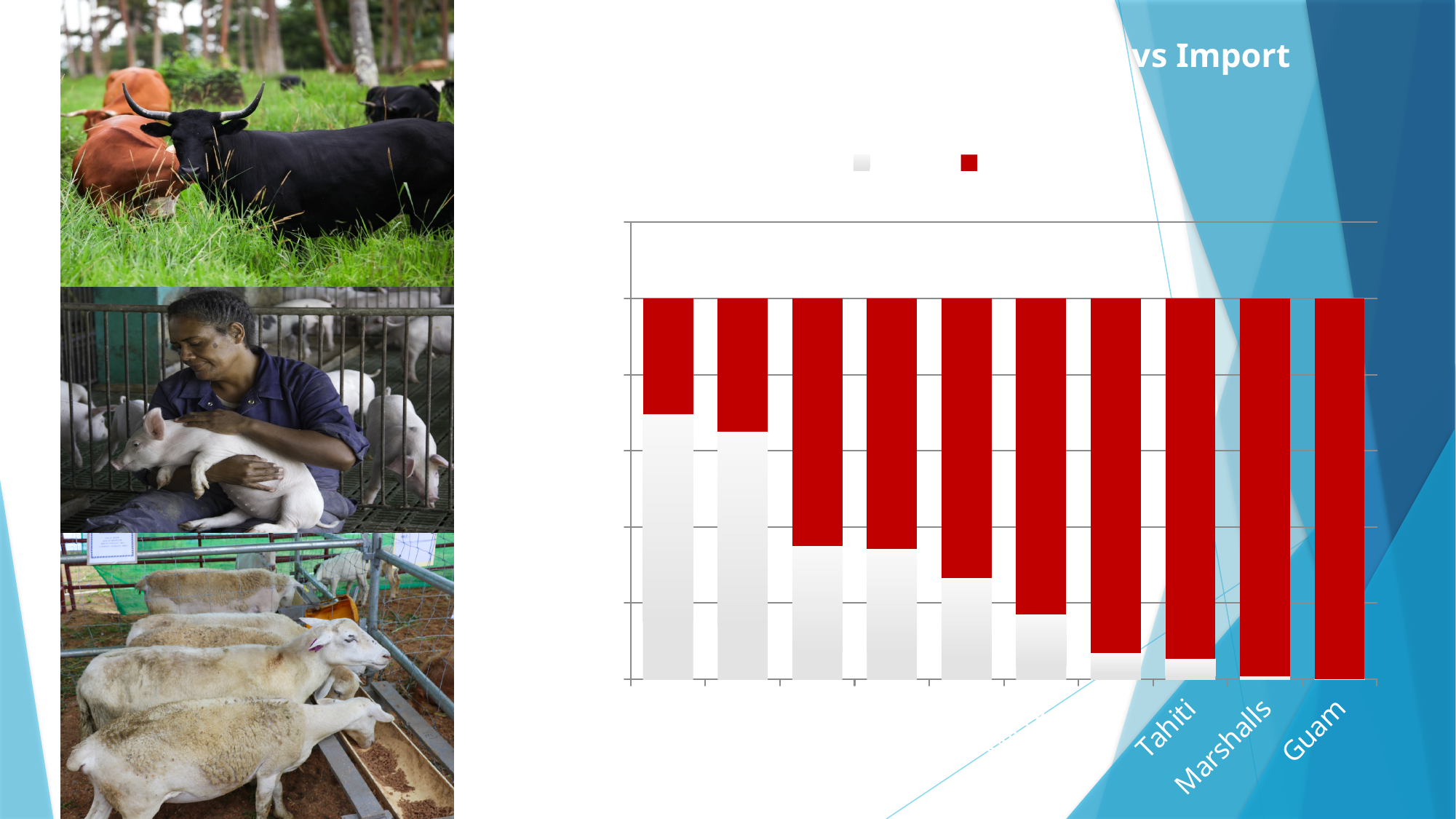
Which category label appears at the far right of the x axis? Guam Moving from left to right along the x axis, does the red portion of the bars rise or fall? Rise Which has the larger grey segment, Tahiti or Guam? Tahiti How many bars (categories) are plotted in the chart? 10 Moving from left to right along the x axis, does the grey portion of the bars rise or fall? Fall How many series does the chart's legend list? 2 What kind of chart is shown on the slide? Stacked bar chart What two colours are used for the series in the chart? Grey and red Which has the larger red segment, Guam or Tahiti? Guam